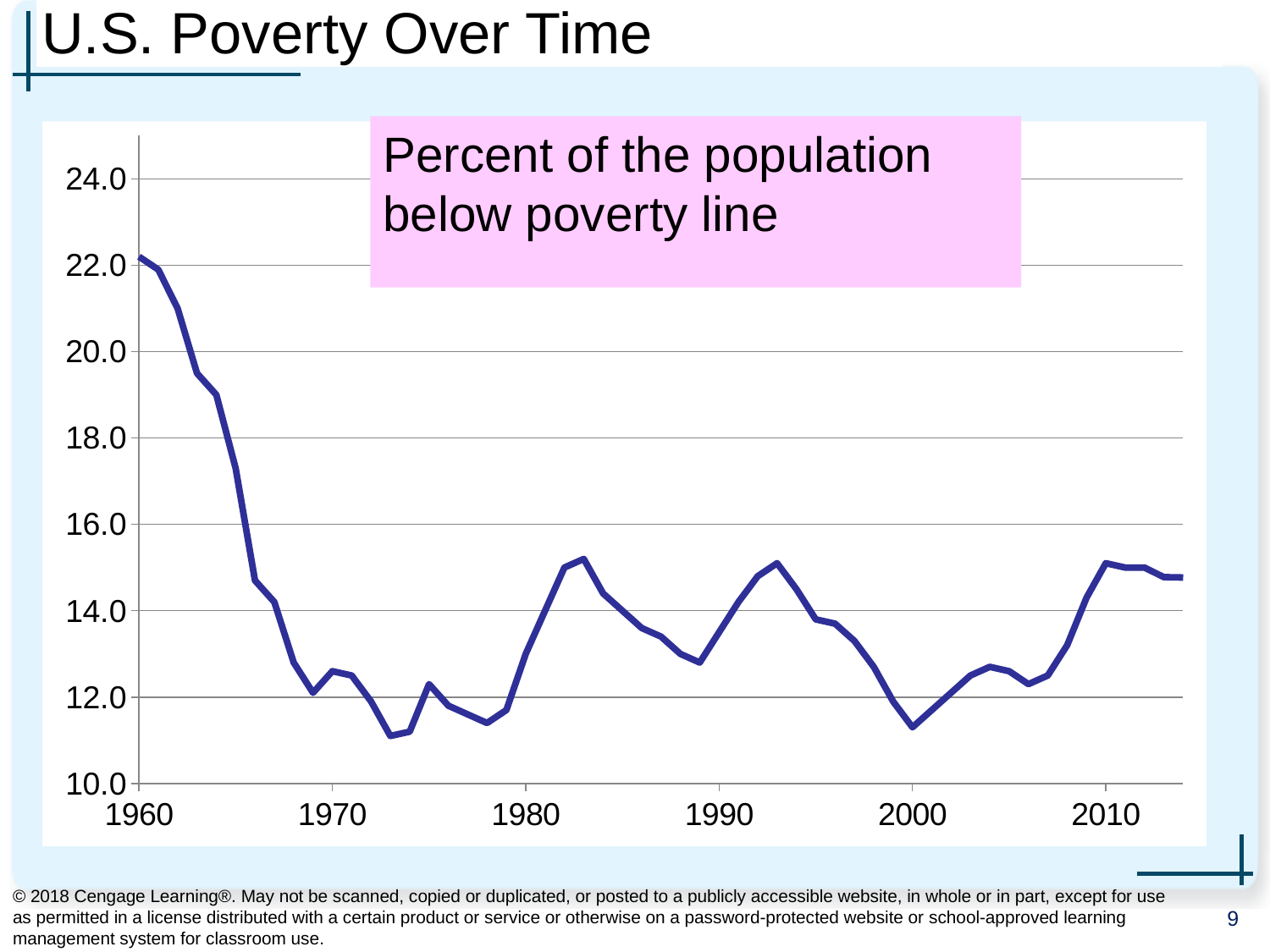
Does the poverty rate rise or fall between 1960 and 1970? fall Is the value for 1970 greater or less than 14.0? less What is the title of the slide's chart? U.S. Poverty Over Time Is the value for 1990 greater or less than 16.0? less Which year has the larger poverty rate, 1990 or 2000? 1990 What kind of chart is shown on the slide? line chart According to the text box on the chart, what does the line represent? Percent of the population below poverty line Is the value for 2010 greater or less than 14.0? greater Which year has the larger poverty rate, 1960 or 2010? 1960 In which year shown on the x axis is the poverty rate highest? 1960